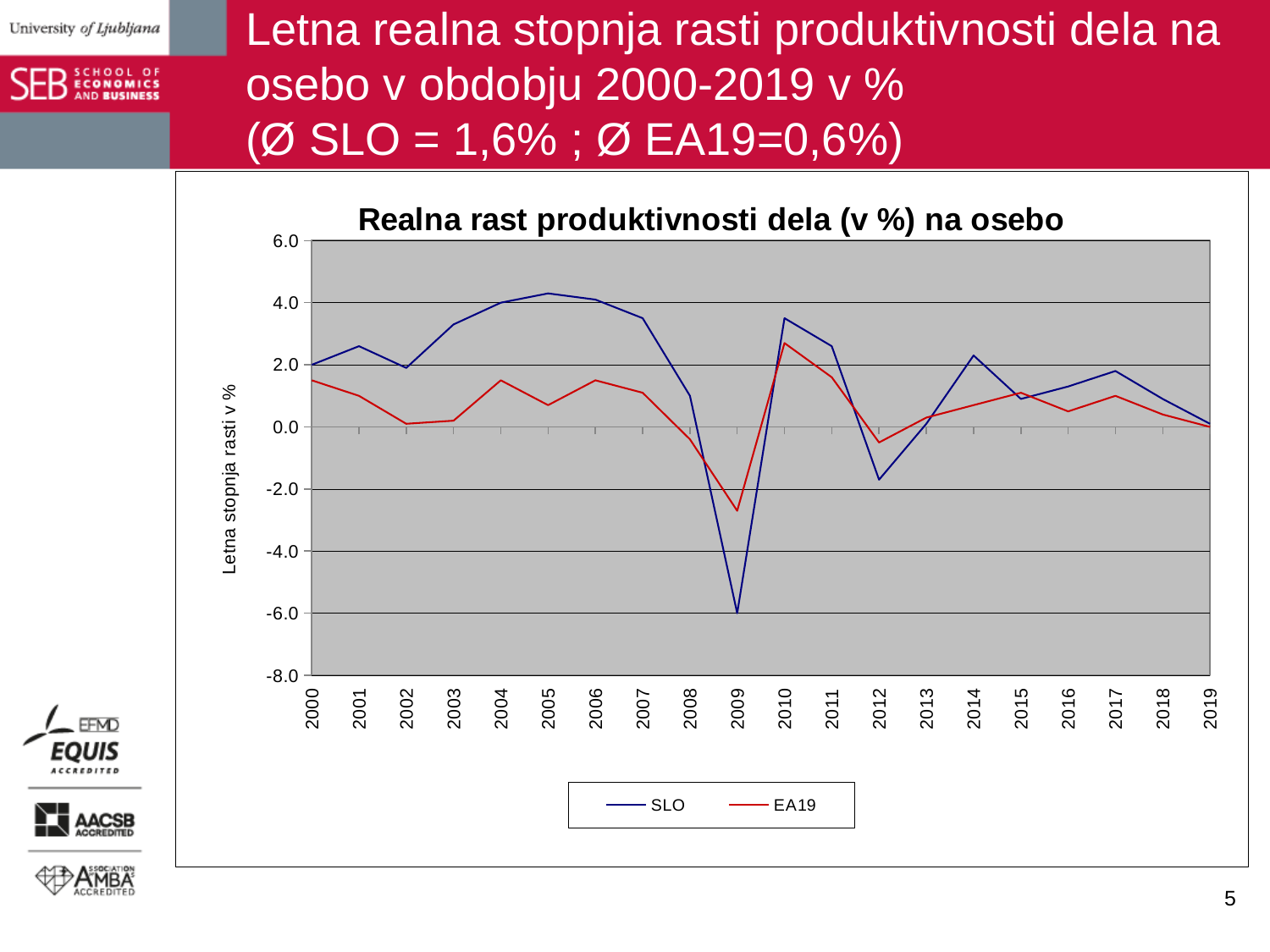
How many series does the legend list? 2 In which year does the SLO series reach its lowest value? 2009 Which series has the larger value in 2005, SLO or EA19? SLO Is the SLO value for 2009 greater or less than -4.0? less Is the EA19 value for 2009 greater or less than -2.0? less What kind of chart is shown on the slide? line chart In which year does the EA19 series reach its lowest value? 2009 In which year does the EA19 series reach its highest value? 2010 How many years are plotted along the x axis? 20 In which year does the SLO series reach its highest value? 2005 Does the SLO series rise or fall from 2005 to 2009? fall Is the SLO value for 2005 greater or less than 4.0? greater